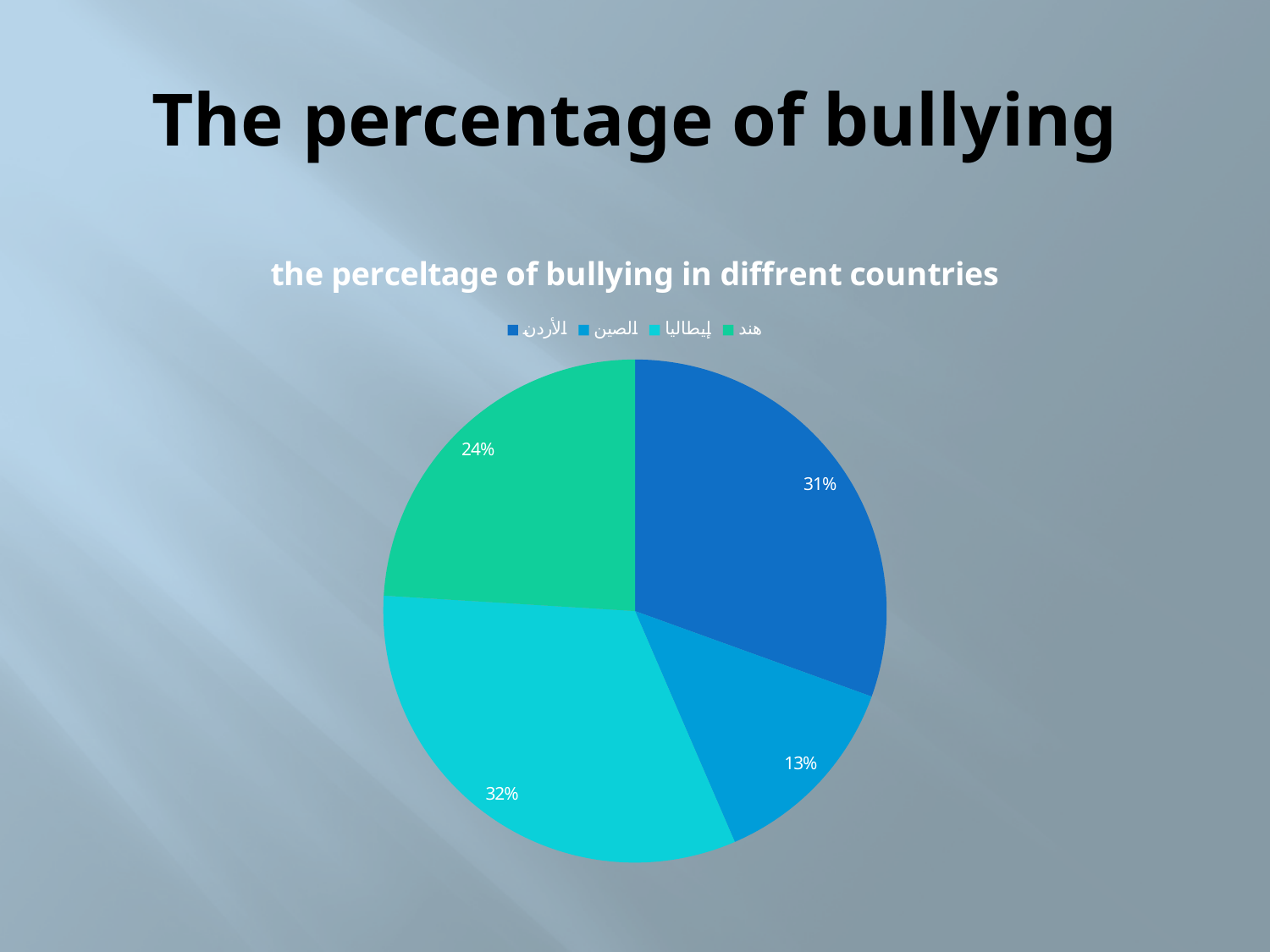
What kind of chart is shown on the slide? Pie chart What percentage is shown on the light cyan slice of the pie chart? 32% How many slices does the pie chart have? 4 How many entries does the legend of the pie chart list? 4 Which slice is larger in the pie chart, the dark blue slice or the green slice? The dark blue slice What is the value of the smallest slice in the pie chart? 13% What percentage is shown on the green slice of the pie chart? 24% What is the value of the largest slice in the pie chart? 32% What is the difference between the largest slice (32%) and the smallest slice (13%) in the pie chart? 19 percentage points What percentage is shown on the dark blue slice of the pie chart? 31% What is the chart title shown above the pie chart? the perceltage of bullying in diffrent countries What do the four labelled slices of the pie chart add up to? 100%